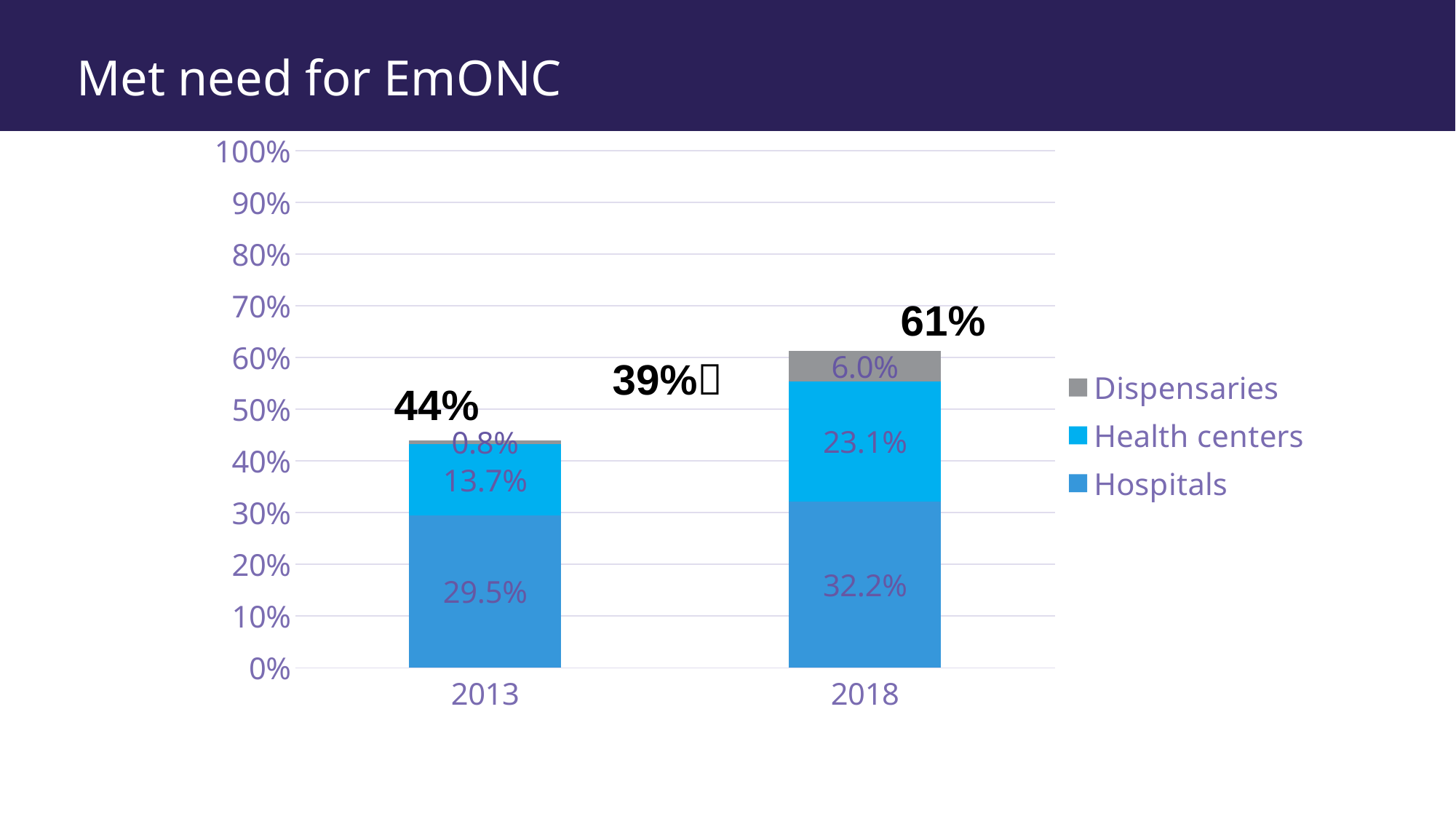
What is the total met need shown above the 2013 bar? 44% What is the total met need shown above the 2018 bar? 61% What is the title of the chart? Met need for EmONC Is the Hospitals value larger in 2013 or 2018? 2018 What is the value for Dispensaries in 2013? 0.8% What is the value for Hospitals in 2013? 29.5% What is the value for Dispensaries in 2018? 6.0% What is the value for Health centers in 2018? 23.1% Which year has the higher total met need for EmONC? 2018 How many series does the legend list? 3 What is the difference between the Health centers values in 2018 and 2013? 9.4% What kind of chart is shown on the slide? Stacked bar chart